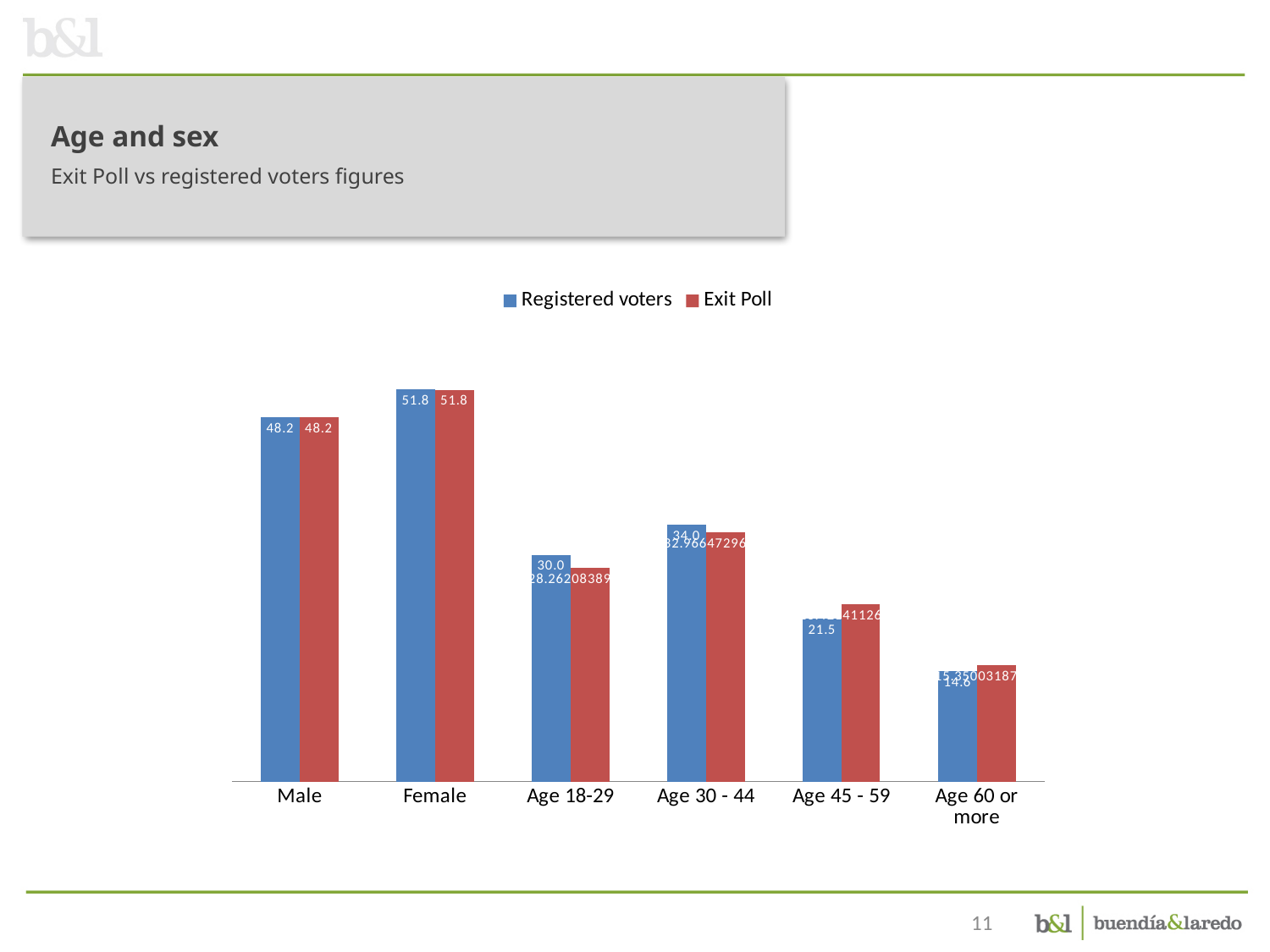
For Age 18-29, which is larger: the Registered voters value or the Exit Poll value? Registered voters What is the difference between the Registered voters values for Female and Male? 3.6 Which category has the highest Registered voters value? Female What is the Registered voters value for Age 18-29? 30.0 What is the Exit Poll value for Female? 51.8 How many series does the legend list? 2 What is the Registered voters value for Age 45 - 59? 21.5 What is the Registered voters value for Male? 48.2 What is the Registered voters value for Age 30 - 44? 34.0 How many categories are shown along the x axis? 6 Which category has the lowest Registered voters value? Age 60 or more What kind of chart is shown on the slide? bar chart